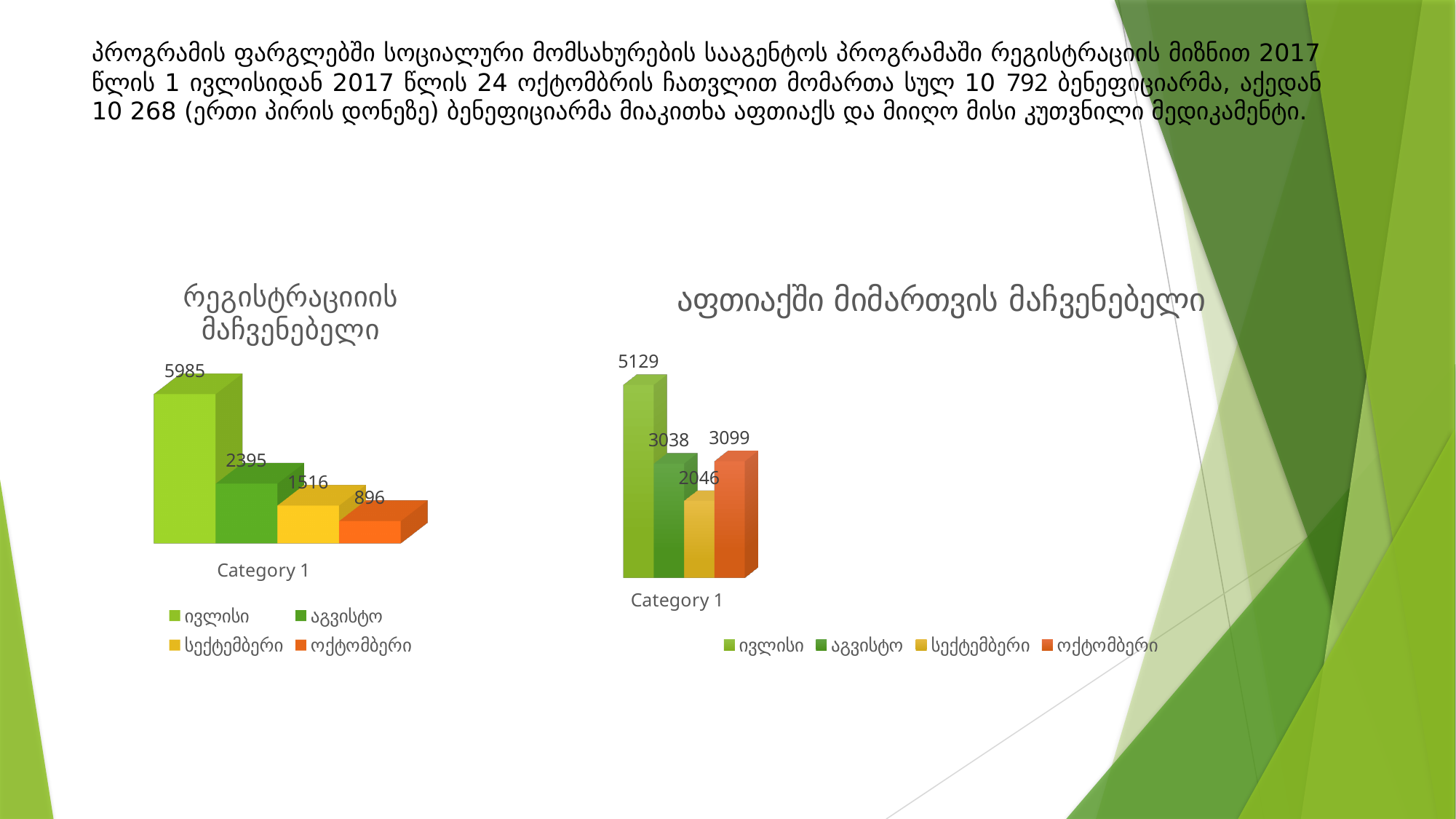
What is the title of the chart on the left of the slide? რეგისტრაციიის მაჩვენებელი In the right chart, which is larger: the value for ოქტომბერი or the value for სექტემბერი? ოქტომბერი In the chart titled "აფთიაქში მიმართვის მაჩვენებელი" (right), what is the value for აგვისტო? 3038 In the chart titled "რეგისტრაციიის მაჩვენებელი" (left), what is the value for ივლისი? 5985 How many series does the legend of the left chart list? 4 In the chart titled "აფთიაქში მიმართვის მაჩვენებელი" (right), what is the value for სექტემბერი? 2046 In the right chart, what is the difference between the values for ოქტომბერი and სექტემბერი? 1053 In the left chart, what is the difference between the values for ივლისი and აგვისტო? 3590 In the left chart, which series has the lowest value? ოქტომბერი What kind of chart is the chart titled "აფთიაქში მიმართვის მაჩვენებელი"? Bar chart In the chart titled "რეგისტრაციიის მაჩვენებელი" (left), what is the value for ოქტომბერი? 896 In the right chart, which series has the highest value? ივლისი